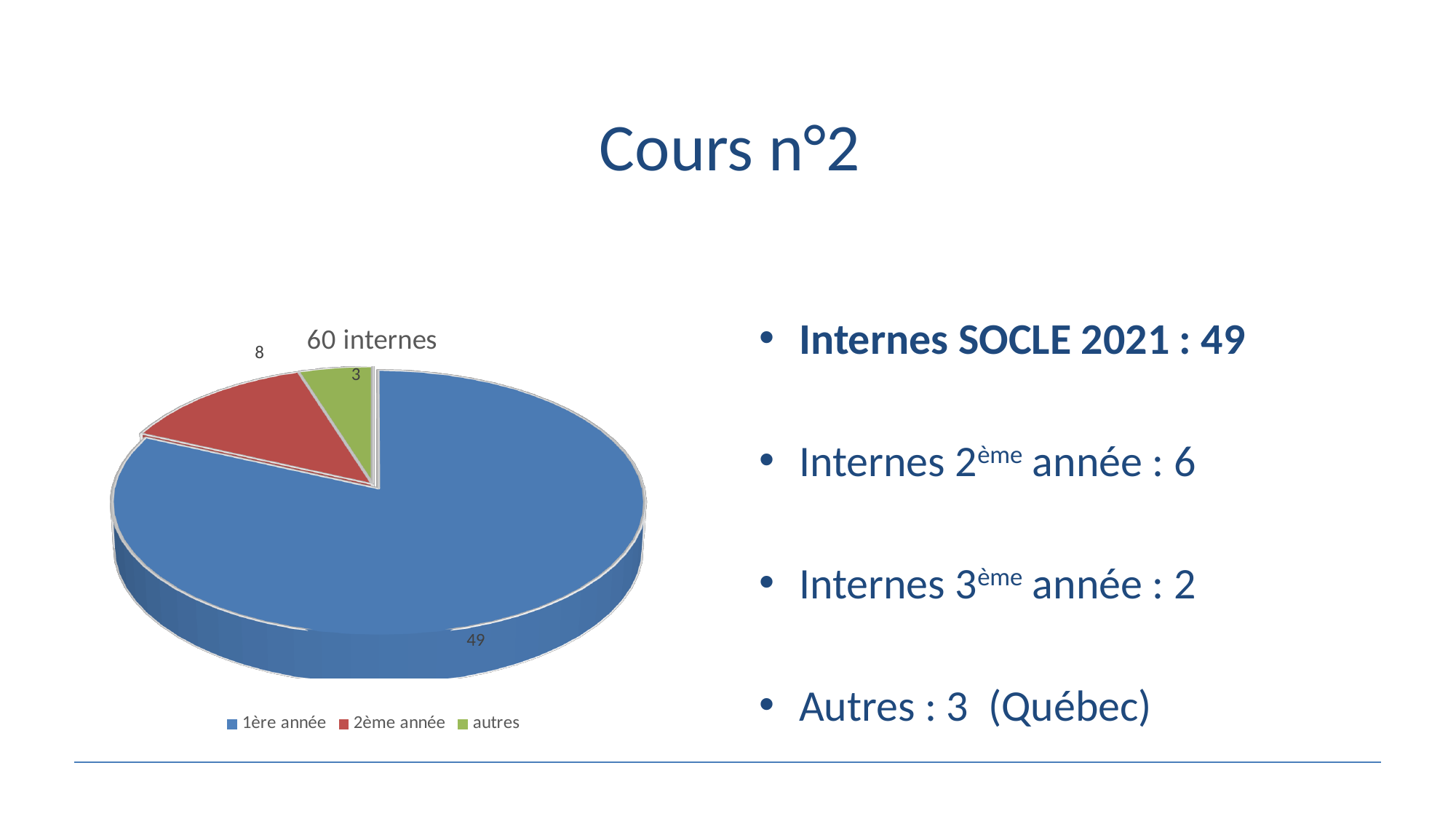
What is the title of the pie chart? 60 internes Which category has the smallest slice in the pie chart? autres Which category has the largest slice in the pie chart? 1ère année What is the difference between the values for 2ème année and autres? 5 What is the value for 1ère année in the pie chart? 49 What is the value for 2ème année in the pie chart? 8 What is the value for autres in the pie chart? 3 Which is larger, the value for 2ème année or the value for autres? 2ème année What is the difference between the values for 1ère année and 2ème année? 41 What type of chart is shown on the slide? pie chart What share of the pie does the autres slice represent? 5% How many slices does the pie chart have? 3